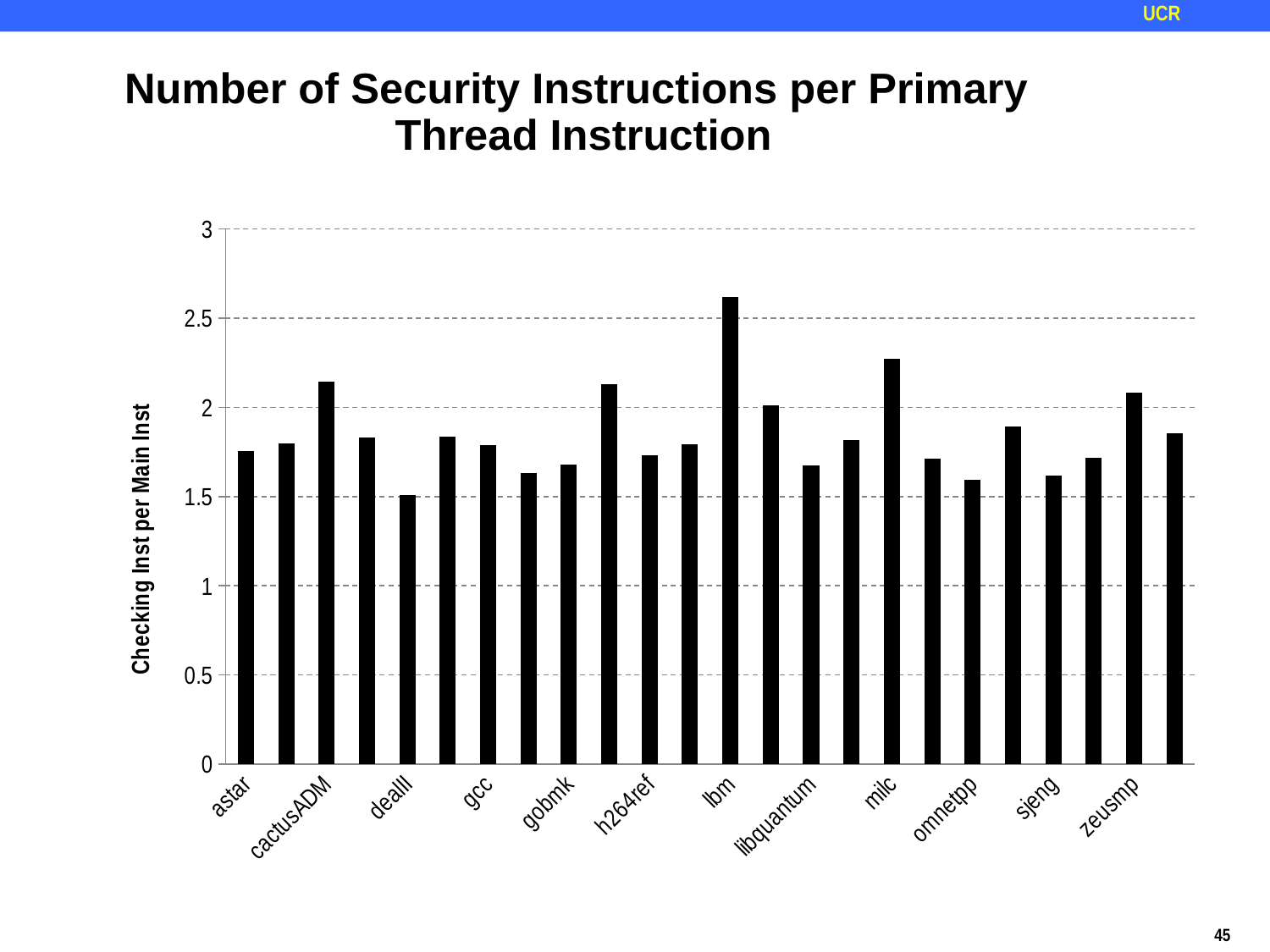
Which category has the lowest value? dealII Which is larger, the value for astar or the value for dealII? astar Which is larger, the value for cactusADM or the value for gcc? cactusADM Is the value for cactusADM greater or less than 2? greater What is the label of the y axis? Checking Inst per Main Inst Is the value for gobmk greater or less than 2? less Is the value for milc greater or less than 2? greater Which is larger, the value for lbm or the value for milc? lbm Which category has the highest value? lbm What kind of chart is shown on the slide? bar chart